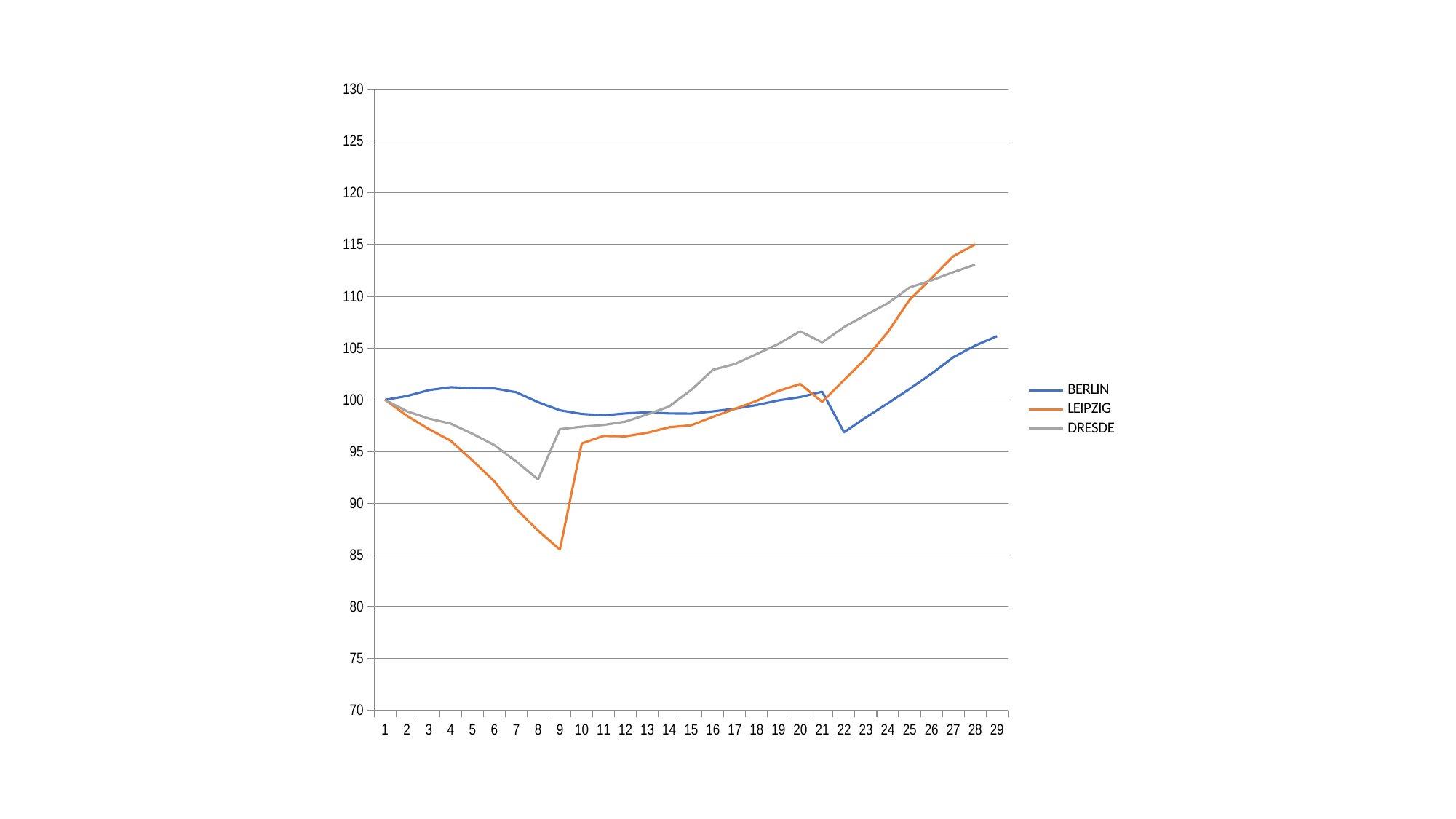
Is the value for BERLIN at point 29 greater or less than 105? greater What kind of chart is shown on the slide? line chart At point 28, which series has the higher value, LEIPZIG or BERLIN? LEIPZIG What is the value for LEIPZIG at point 28? 115 Is the value for LEIPZIG at point 9 greater or less than 90? less At point 9, which series has the higher value, BERLIN or LEIPZIG? BERLIN Does the DRESDE line generally rise or fall between point 9 and point 28? rise How many points are labelled along the x axis? 29 Is the value for DRESDE at point 8 greater or less than 95? less Which series reaches the lowest value anywhere on the chart? LEIPZIG What is the value for BERLIN at point 1? 100 How many series does the legend list? 3